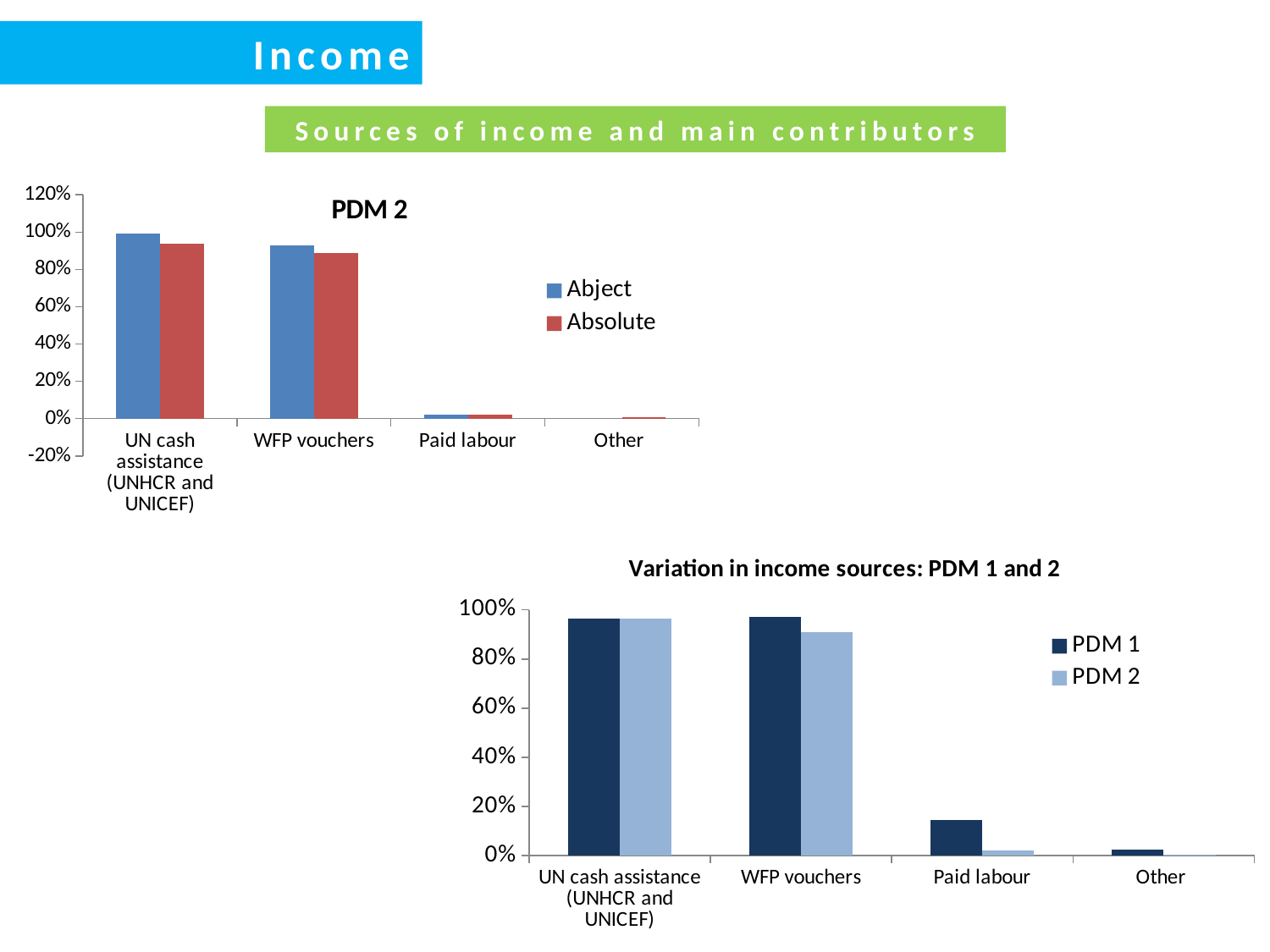
In the 'PDM 2' chart, how many series does the legend list? 2 What are the legend entries of the 'Variation in income sources: PDM 1 and 2' chart? PDM 1 and PDM 2 In the 'PDM 2' chart, for UN cash assistance (UNHCR and UNICEF), which series has the larger value, Abject or Absolute? Abject In the 'Variation in income sources: PDM 1 and 2' chart, is the PDM 2 value for WFP vouchers greater or less than 80%? greater In the 'Variation in income sources: PDM 1 and 2' chart, is the PDM 1 value for Paid labour greater or less than 20%? less In the 'PDM 2' chart, is the Abject value for WFP vouchers greater or less than 80%? greater In the 'PDM 2' chart, which category has the lowest value for the Abject series? Other In the 'Variation in income sources: PDM 1 and 2' chart, for Paid labour, which series has the larger value, PDM 1 or PDM 2? PDM 1 In the 'PDM 2' chart, which category has the highest value for the Abject series? UN cash assistance (UNHCR and UNICEF) In the 'PDM 2' chart, how many income source categories are shown on the x axis? 4 In the 'Variation in income sources: PDM 1 and 2' chart, how many series does the legend list? 2 What kind of chart is the 'PDM 2' chart at the top of the slide? bar chart